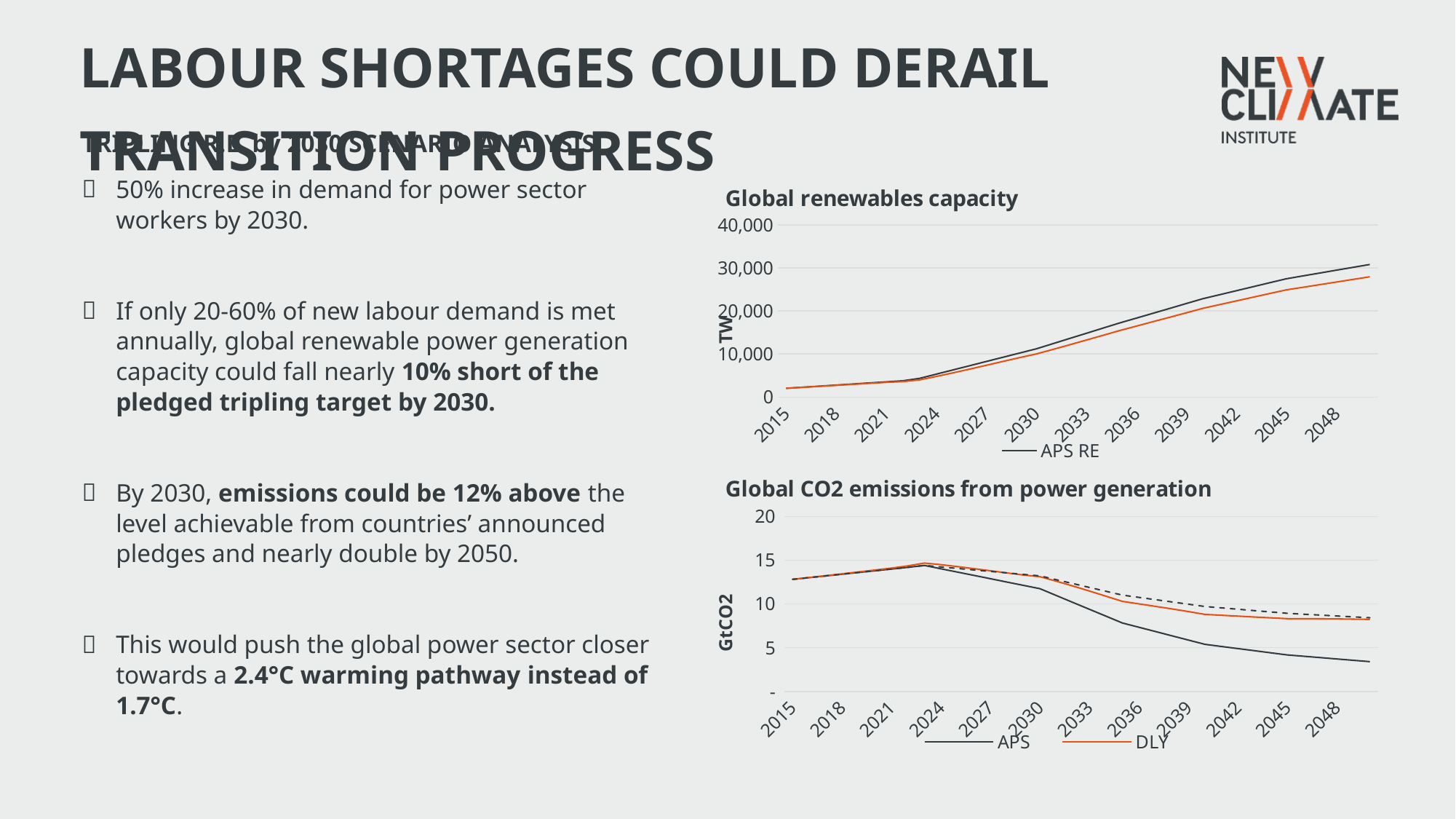
In the 'Global CO2 emissions from power generation' chart, what unit is shown on the y-axis? GtCO2 In the 'Global renewables capacity' chart, is the orange line's value for 2048 greater or less than 30,000? less In the 'Global CO2 emissions from power generation' chart, which series is higher in 2048, APS or DLY? DLY In the 'Global renewables capacity' chart, do the values rise or fall from 2015 to 2048? rise In the 'Global CO2 emissions from power generation' chart, is the APS value for 2048 greater or less than 5? less In the 'Global renewables capacity' chart, is the APS RE value for 2036 greater or less than 10,000? greater How many series does the legend of the 'Global CO2 emissions from power generation' chart list? 2 In the 'Global CO2 emissions from power generation' chart, does the APS line rise or fall from 2024 to 2048? fall What type of chart is the 'Global CO2 emissions from power generation' chart? line chart In the 'Global renewables capacity' chart, what unit is shown on the y-axis? TW How many year labels are shown on the x-axis of the 'Global renewables capacity' chart? 12 What type of chart is the 'Global renewables capacity' chart? line chart